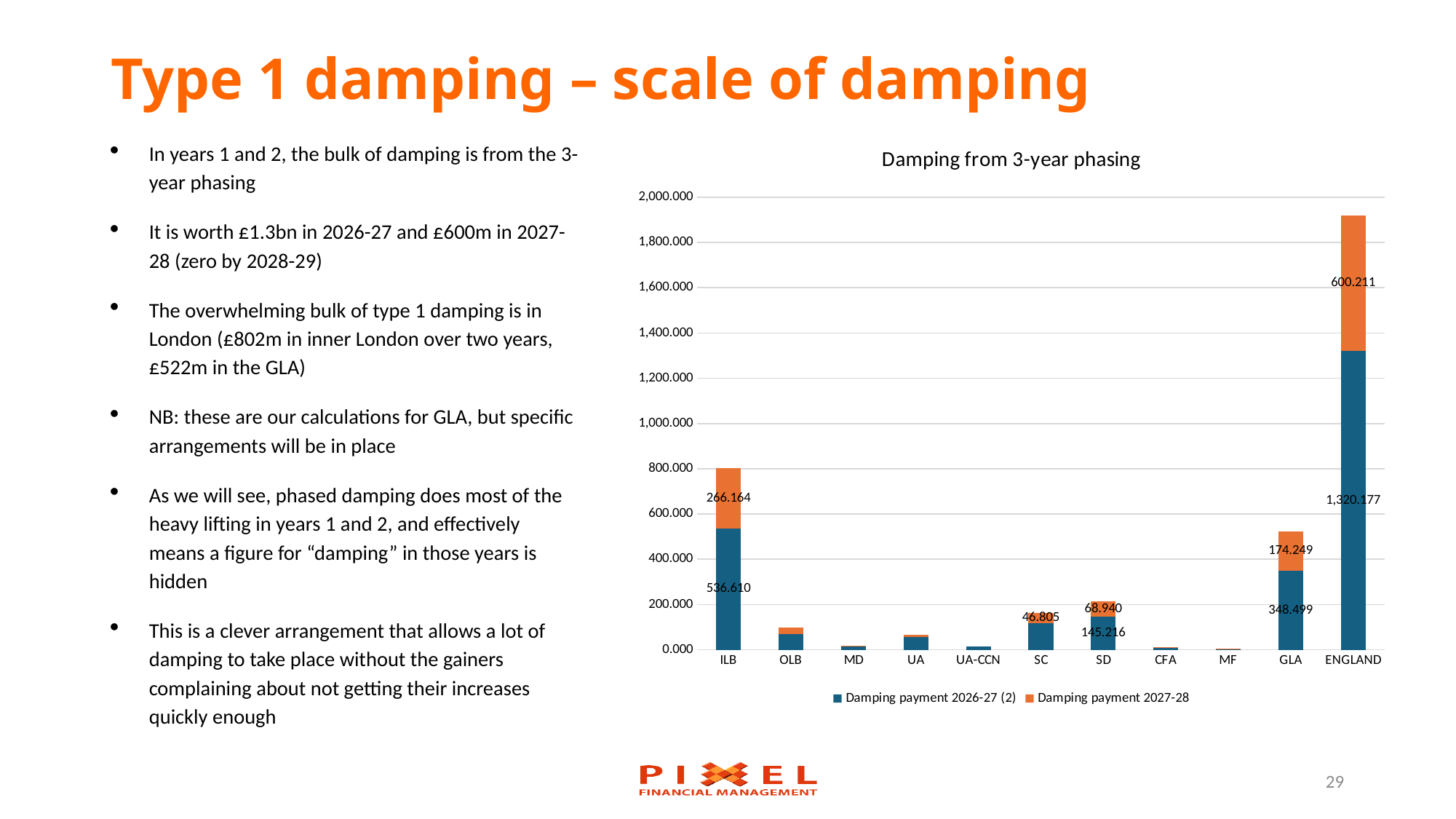
What is the Damping payment 2027-28 value for ILB? 266.164 What type of chart is shown on the slide? Stacked bar chart What is the Damping payment 2026-27 (2) value for ENGLAND? 1,320.177 Which has the larger total bar, ILB or GLA? ILB What is the title of the chart? Damping from 3-year phasing How many categories are shown on the x axis of the chart? 11 Which category has the highest total bar in the chart? ENGLAND What is the difference between the Damping payment 2026-27 (2) and Damping payment 2027-28 values for ENGLAND? 719.966 Is the total bar for OLB greater or less than 200.000? less How many series does the chart legend list? 2 What is the Damping payment 2026-27 (2) value for GLA? 348.499 What is the total of the stacked bar for ILB? 802.774